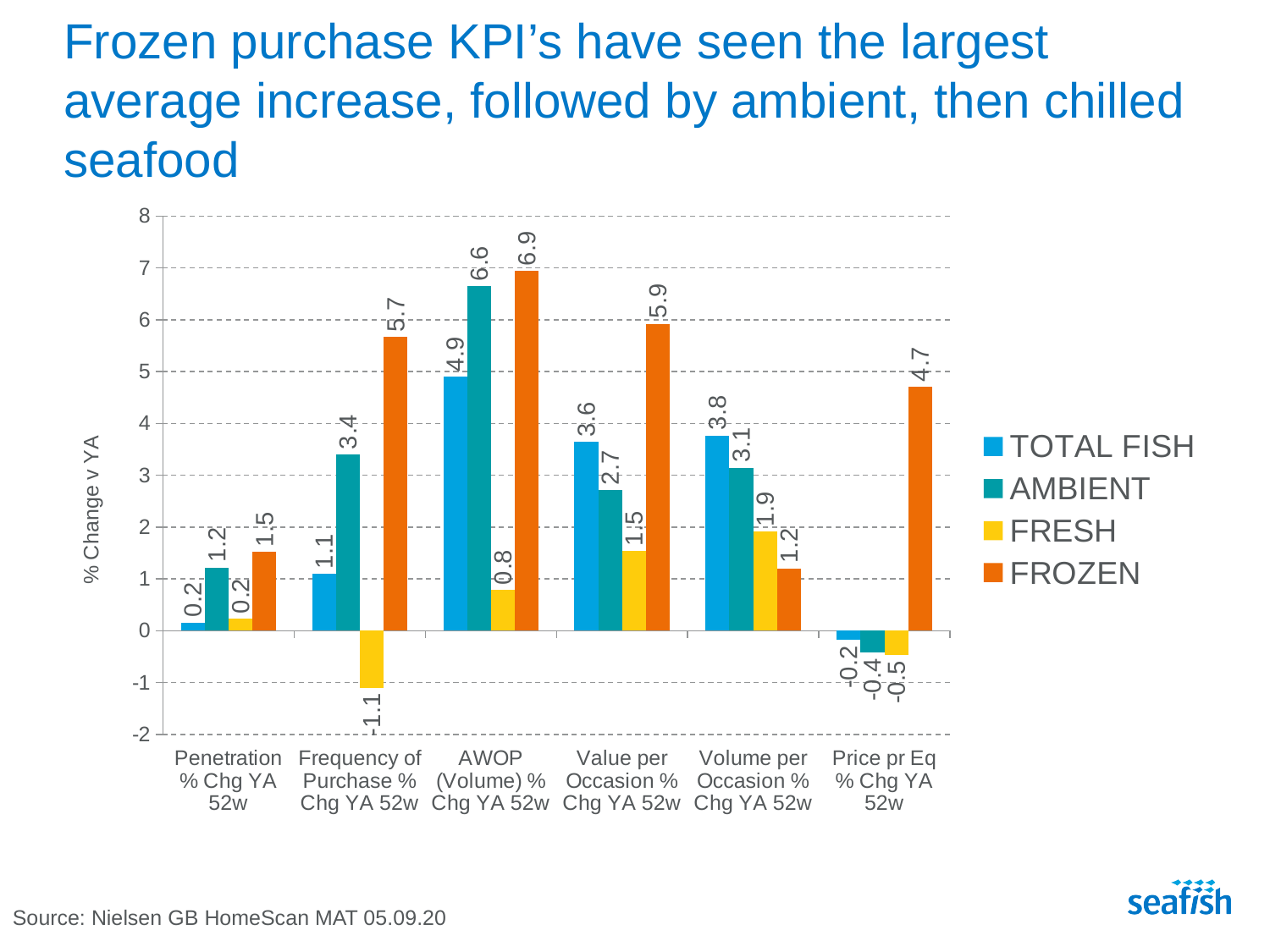
What is the value for FRESH in the Frequency of Purchase % Chg YA 52w category? -1.1 In which category does the FRESH series have its lowest value? Frequency of Purchase % Chg YA 52w How many series does the legend list? 4 What is the value for FROZEN in the AWOP (Volume) % Chg YA 52w category? 6.9 Is the FROZEN value for Price pr Eq % Chg YA 52w greater or less than 4? greater How many categories are shown on the x axis? 6 What kind of chart is shown on the slide? Bar chart Which is larger in the Volume per Occasion % Chg YA 52w category: TOTAL FISH or FROZEN? TOTAL FISH What is the difference between the FROZEN and AMBIENT values in the Frequency of Purchase % Chg YA 52w category? 2.3 What is the value for TOTAL FISH in the Value per Occasion % Chg YA 52w category? 3.6 In which category does the FROZEN series reach its highest value? AWOP (Volume) % Chg YA 52w What is the value for AMBIENT in the Price pr Eq % Chg YA 52w category? -0.4